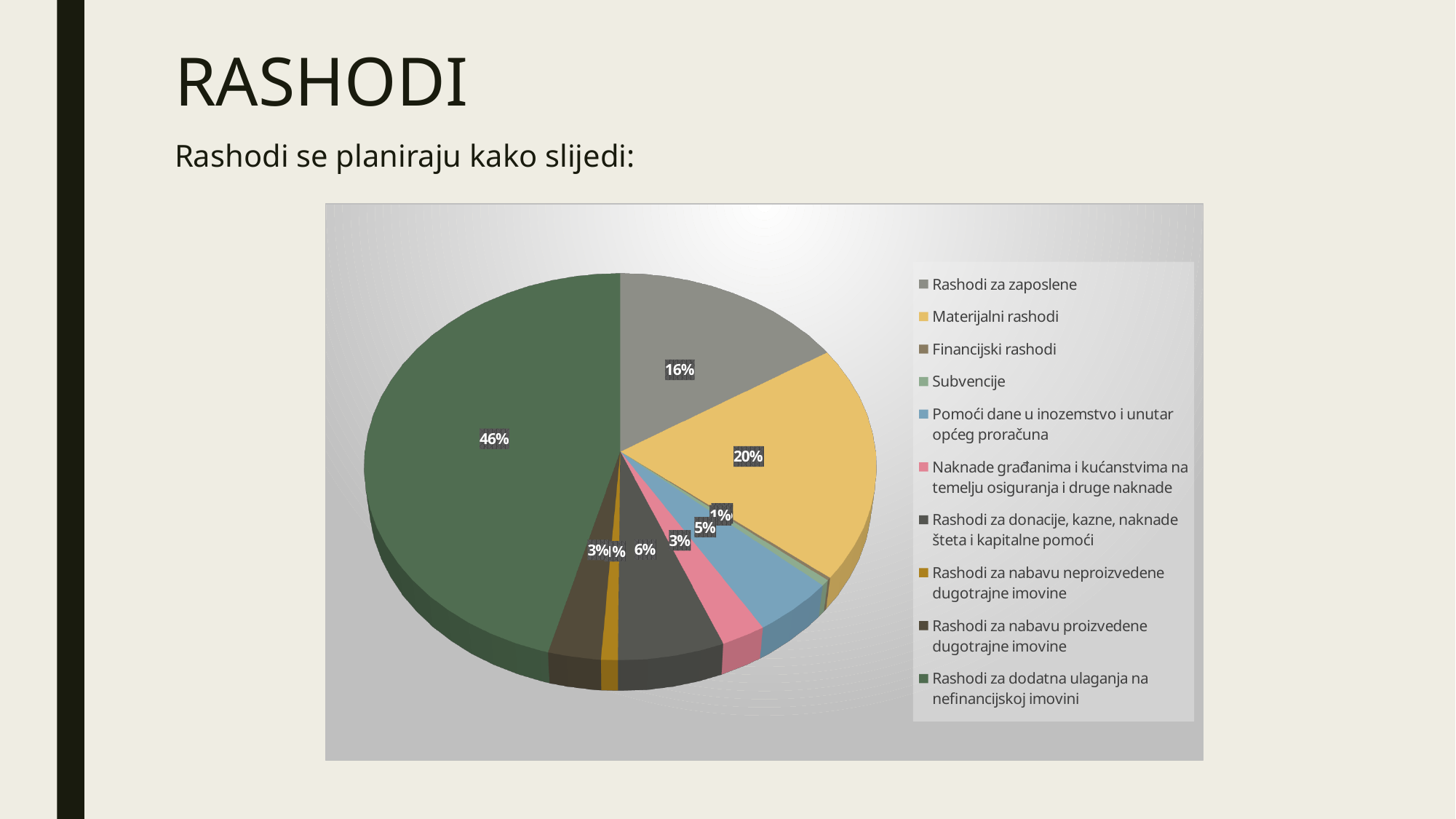
Which category has the largest share of the pie? Rashodi za dodatna ulaganja na nefinancijskoj imovini What percentage is shown for 'Rashodi za donacije, kazne, naknade šteta i kapitalne pomoći'? 6% What percentage is shown for 'Naknade građanima i kućanstvima na temelju osiguranja i druge naknade'? 3% What colour is the slice for 'Rashodi za dodatna ulaganja na nefinancijskoj imovini'? green What percentage is shown for 'Pomoći dane u inozemstvo i unutar općeg proračuna'? 5% What type of chart is shown on the slide? pie chart Which is larger: the share for 'Materijalni rashodi' or for 'Rashodi za zaposlene'? Materijalni rashodi What percentage of the pie is 'Rashodi za dodatna ulaganja na nefinancijskoj imovini'? 46% What percentage is shown for 'Materijalni rashodi'? 20% What is the difference in percentage points between 'Rashodi za dodatna ulaganja na nefinancijskoj imovini' and 'Materijalni rashodi'? 26 percentage points How many categories does the legend list? 10 What percentage is shown for 'Rashodi za zaposlene'? 16%